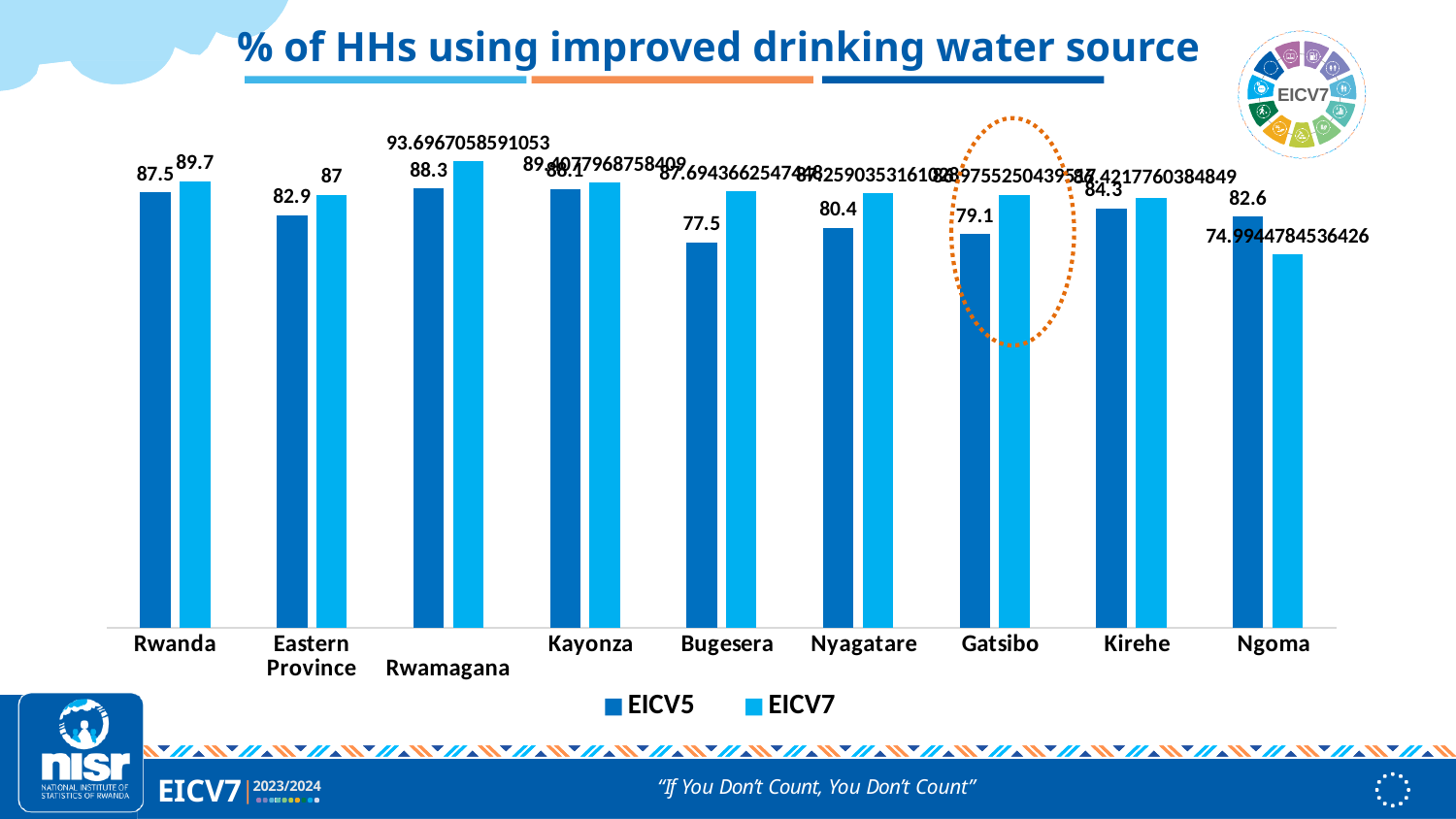
What is the EICV7 value for Eastern Province? 87 Which category has the highest EICV7 value? Rwamagana Which category has the lowest EICV7 value? Ngoma What is the EICV5 value for Gatsibo? 79.1 For Ngoma, which is larger: the EICV5 value or the EICV7 value? EICV5 Which category has the lowest EICV5 value? Bugesera What is the difference between the EICV7 and EICV5 values for Rwanda? 2.2 How many series does the legend list? 2 What is the EICV5 value for Ngoma? 82.6 What is the EICV5 value for Rwanda? 87.5 What is the EICV5 value for Bugesera? 77.5 How many categories are shown on the x axis? 9